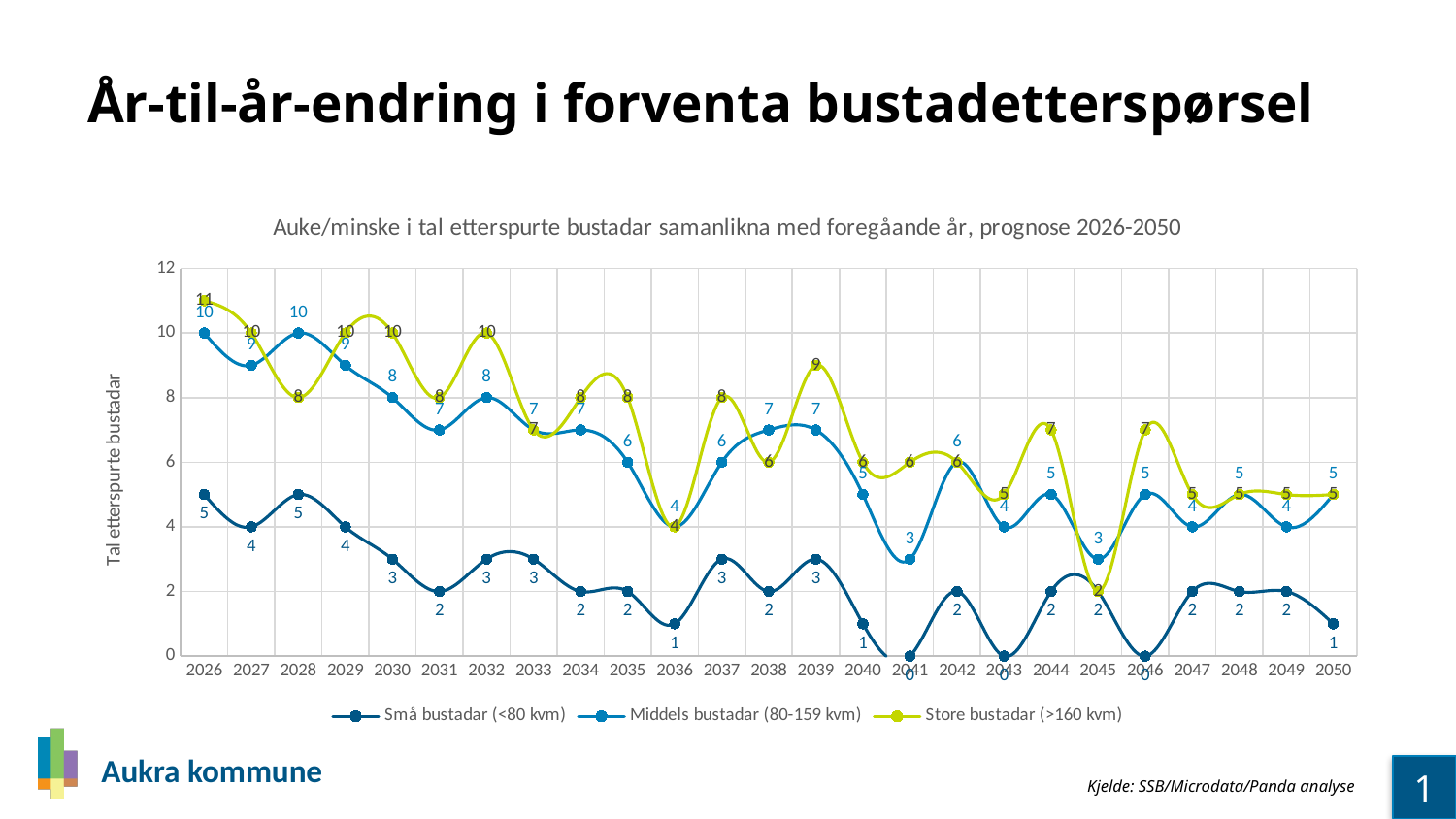
In which year does Store bustadar (>160 kvm) reach its highest value? 2026 In 2039, which series has the larger value: Store bustadar (>160 kvm) or Middels bustadar (80-159 kvm)? Store bustadar (>160 kvm) How many series does the legend list? 3 In which year does Store bustadar (>160 kvm) reach its lowest value? 2045 What is the value for Store bustadar (>160 kvm) in 2026? 11 Does the Middels bustadar (80-159 kvm) series generally rise or fall from 2026 to 2050? fall What is the subtitle shown above the chart? Auke/minske i tal etterspurte bustadar samanlikna med foregåande år, prognose 2026-2050 How many years are plotted along the x axis? 25 What is the value for Små bustadar (<80 kvm) in 2041? 0 What kind of chart is shown on the slide? line chart What is the value for Middels bustadar (80-159 kvm) in 2036? 4 What is the difference between the Middels bustadar (80-159 kvm) value in 2026 and in 2050? 5